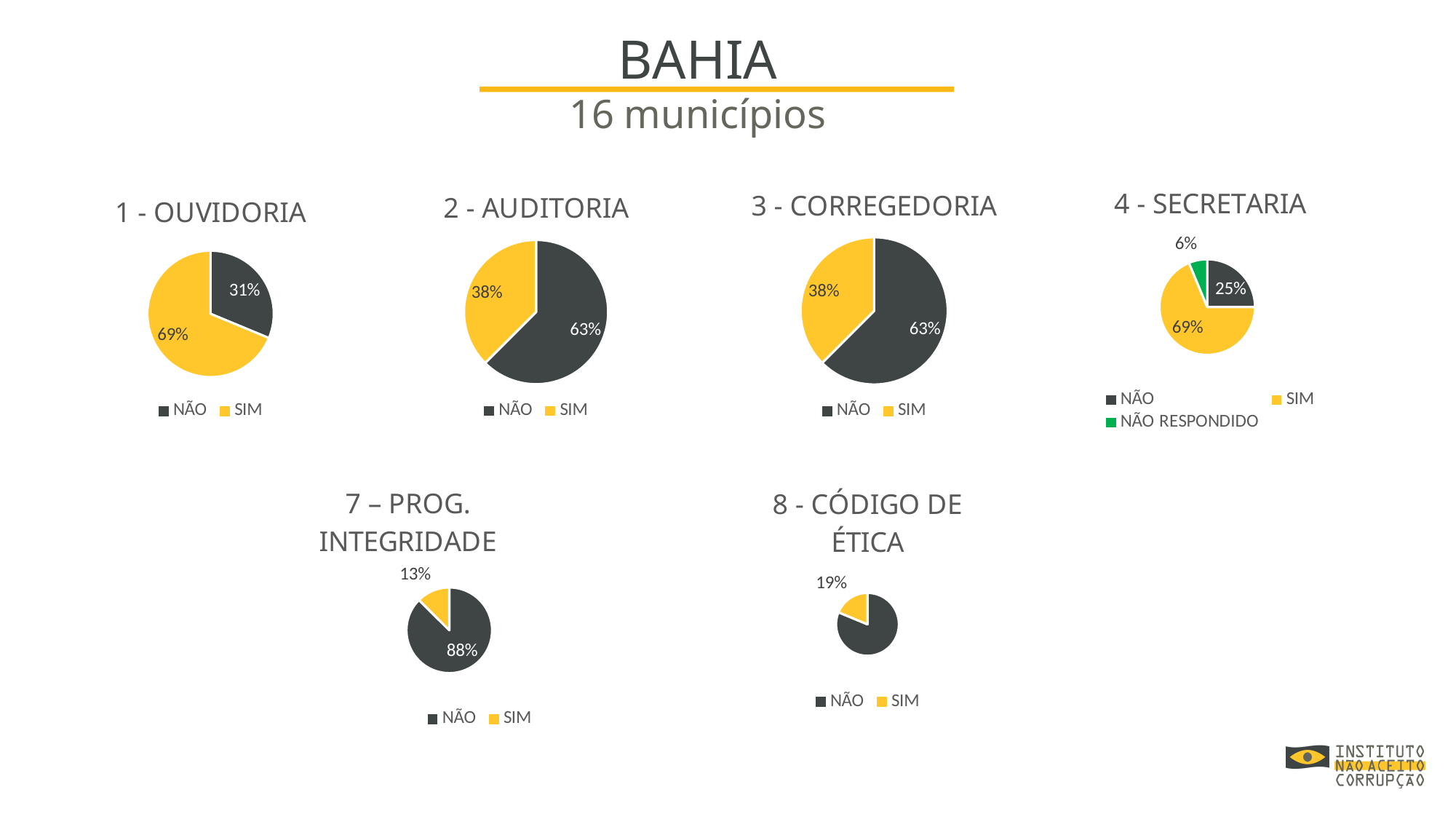
How many entries does the legend of the "4 - SECRETARIA" chart list? 3 In the "3 - CORREGEDORIA" pie chart, what percentage is labelled for SIM? 38% In the "4 - SECRETARIA" pie chart, which category has the largest slice? SIM In the "4 - SECRETARIA" pie chart, what percentage is labelled for NÃO RESPONDIDO? 6% In the "1 - OUVIDORIA" pie chart, what percentage is labelled for NÃO? 31% In the "2 - AUDITORIA" pie chart, what percentage is labelled for NÃO? 63% How many pie charts are shown on the slide? 6 In the "8 - CÓDIGO DE ÉTICA" pie chart, which slice is larger, NÃO or SIM? NÃO In the "4 - SECRETARIA" pie chart, which category has the smallest slice? NÃO RESPONDIDO What type of chart is used for "2 - AUDITORIA"? Pie chart In the "1 - OUVIDORIA" pie chart, what percentage is labelled for SIM? 69% In the "7 – PROG. INTEGRIDADE" pie chart, what is the difference in percentage points between NÃO and SIM? 75